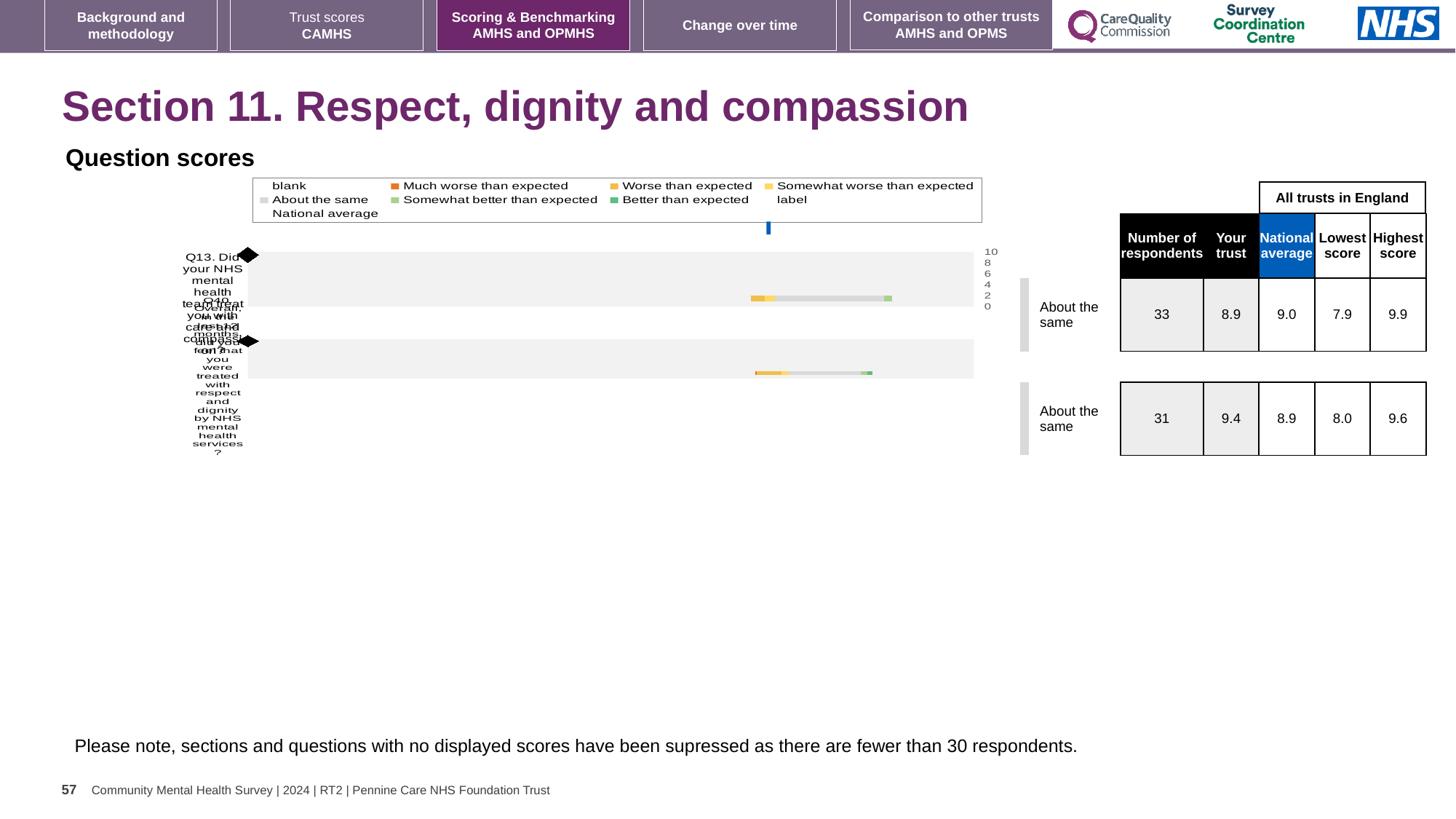
What is the 'Your trust' score for Q13 (care and compassion)? 8.9 What kind of chart is shown under 'Question scores'? bar chart What benchmark category is shown for both Q13 and Q10? About the same How many questions are plotted in the 'Question scores' chart? 2 What is the difference between the 'Your trust' scores for Q10 and Q13? 0.5 Which question has the higher 'Your trust' score, Q13 or Q10? Q10 How many entries does the legend of the 'Question scores' chart list? 9 What is the highest score across all trusts in England for Q13? 9.9 How many respondents answered Q10? 31 What is the lowest score across all trusts in England for Q10? 8.0 What is the 'Your trust' score for Q10 (respect and dignity)? 9.4 What is the national average score for Q13? 9.0